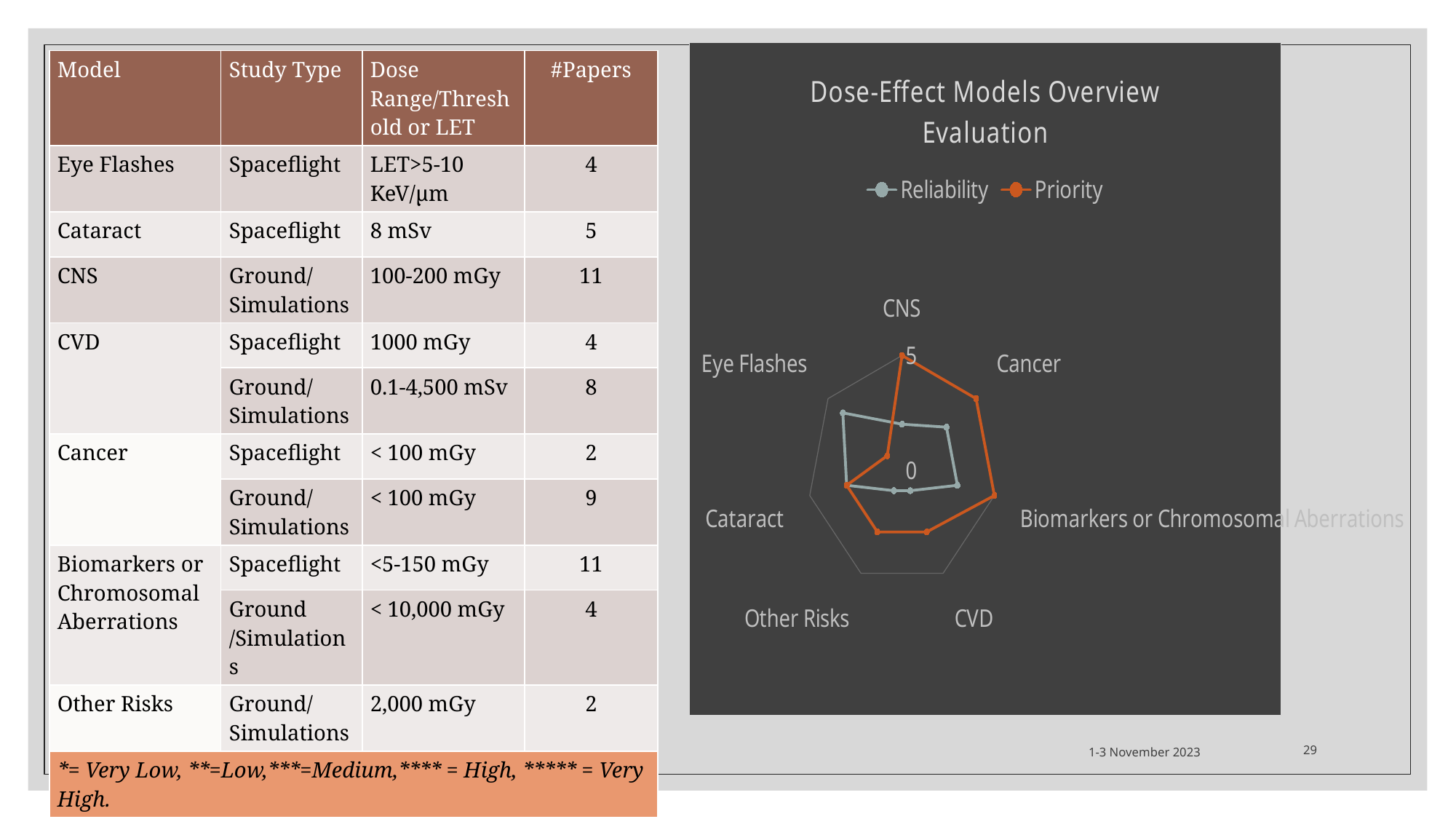
What kind of chart is shown on the slide? Radar chart What is the Priority value for CNS? 5 Which category has the highest Reliability value? Eye Flashes Which two series are listed in the chart legend? Reliability and Priority For Cancer, which series has the larger value, Reliability or Priority? Priority How many categories (axes) does the radar chart have? 7 For CNS, which series has the larger value, Reliability or Priority? Priority For Biomarkers or Chromosomal Aberrations, which series has the larger value, Reliability or Priority? Priority How many series does the chart legend list? 2 What is the title of the chart? Dose-Effect Models Overview Evaluation